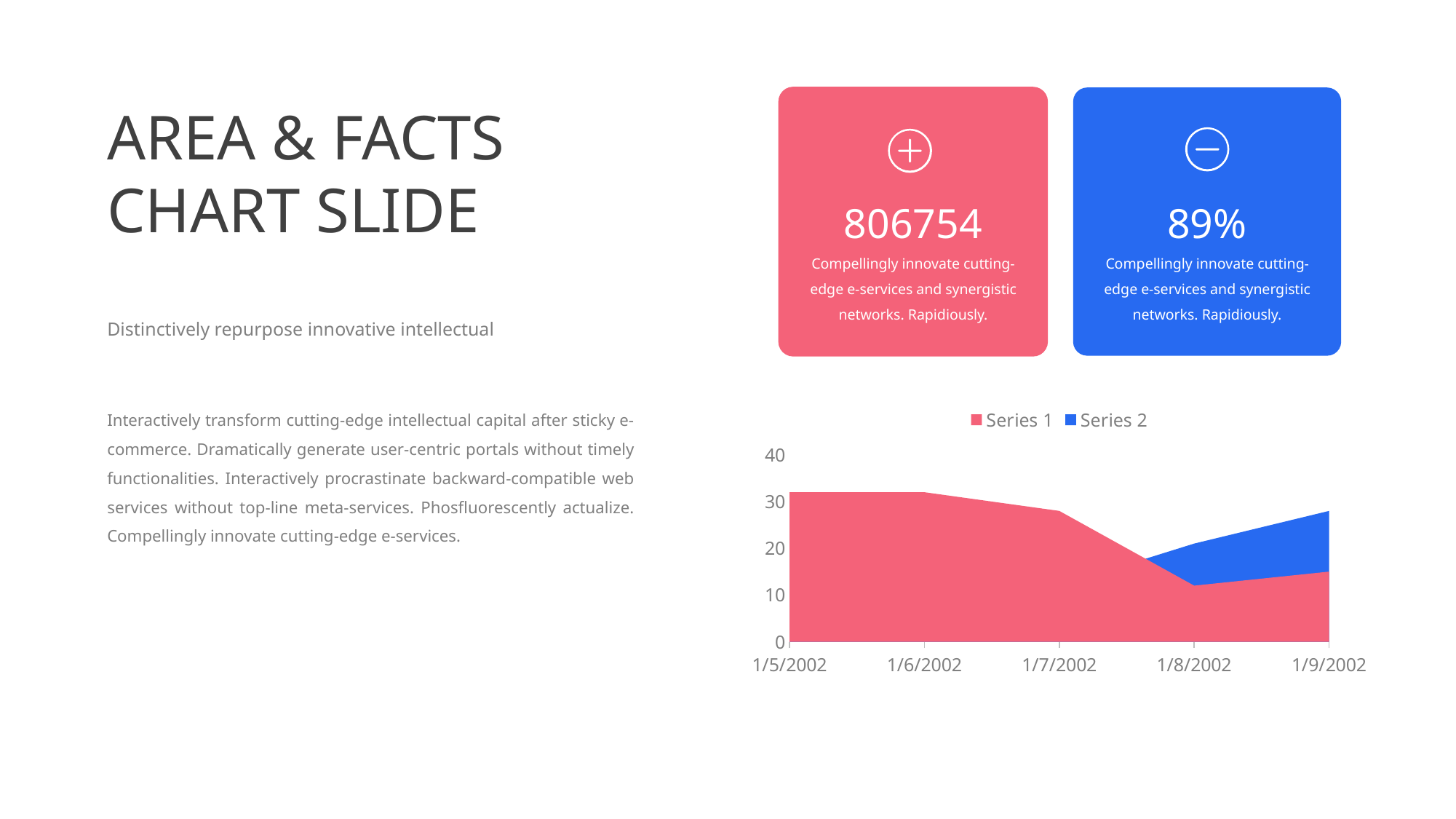
Which is larger for Series 1: the value at 1/7/2002 or the value at 1/9/2002? 1/7/2002 Is the value for Series 1 at 1/8/2002 greater or less than 20? less How many dates are shown on the x axis of the chart? 5 Does the value of Series 1 rise or fall from 1/5/2002 to 1/8/2002? Fall At which date is Series 1 at its lowest value? 1/8/2002 Which is larger for Series 1: the value at 1/5/2002 or the value at 1/8/2002? 1/5/2002 What kind of chart is shown on the slide? Area chart Is the value for Series 1 at 1/7/2002 greater or less than 20? greater Is the value for Series 1 at 1/5/2002 greater or less than 20? greater What are the names of the series in the chart legend? Series 1 and Series 2 What colour is Series 1 in the chart? Pink/red How many series does the chart legend list? 2